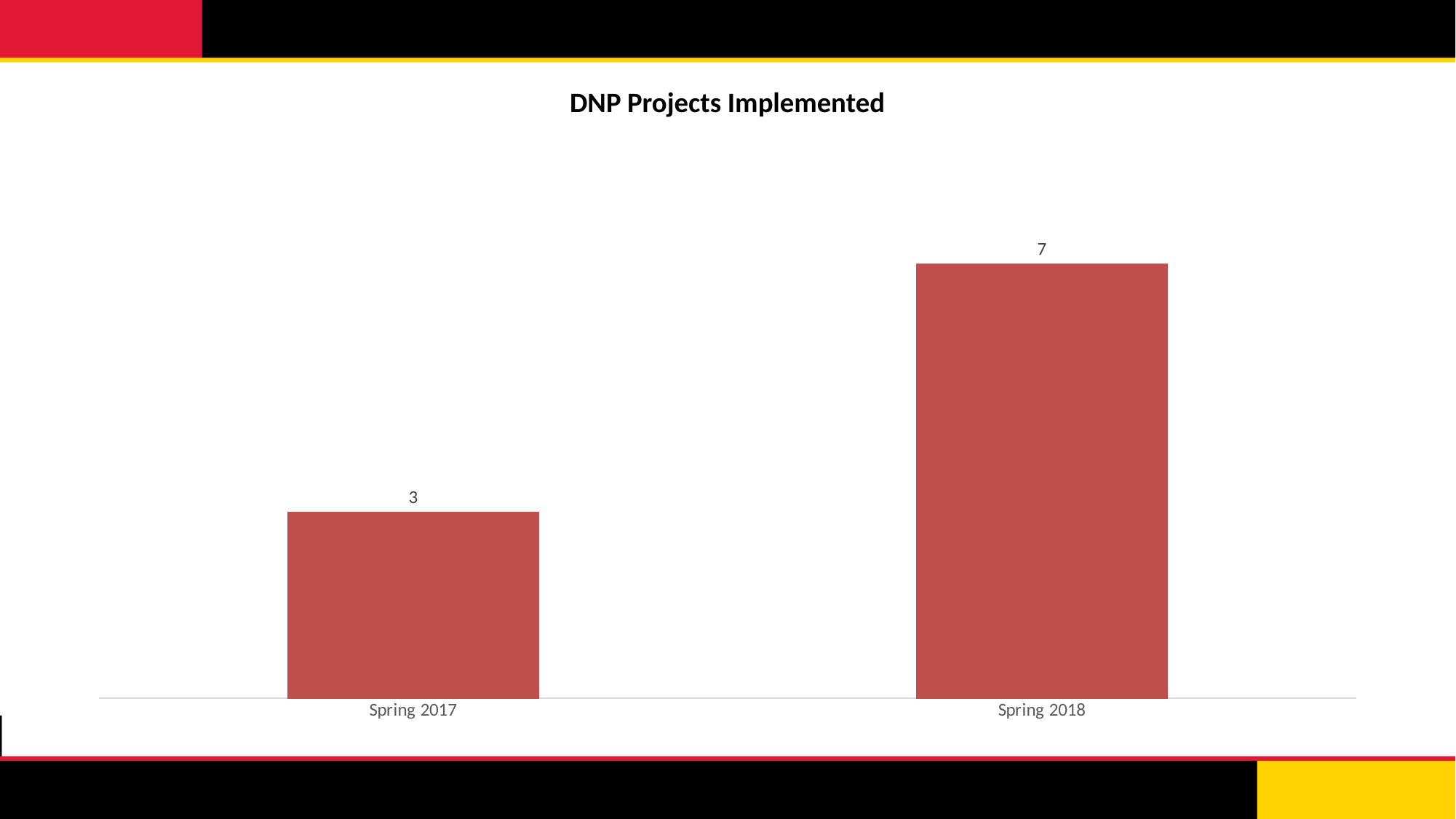
What is the title of the chart? DNP Projects Implemented Which category has the lowest value? Spring 2017 Which category has the highest value? Spring 2018 What kind of chart is shown on the slide? Bar chart Do the values rise or fall from Spring 2017 to Spring 2018? Rise What is the value for Spring 2017? 3 What is the difference between the values for Spring 2018 and Spring 2017? 4 Which is larger, the value for Spring 2017 or Spring 2018? Spring 2018 What colour are the bars in the chart? Red What is the value for Spring 2018? 7 How many categories are shown on the x axis? 2